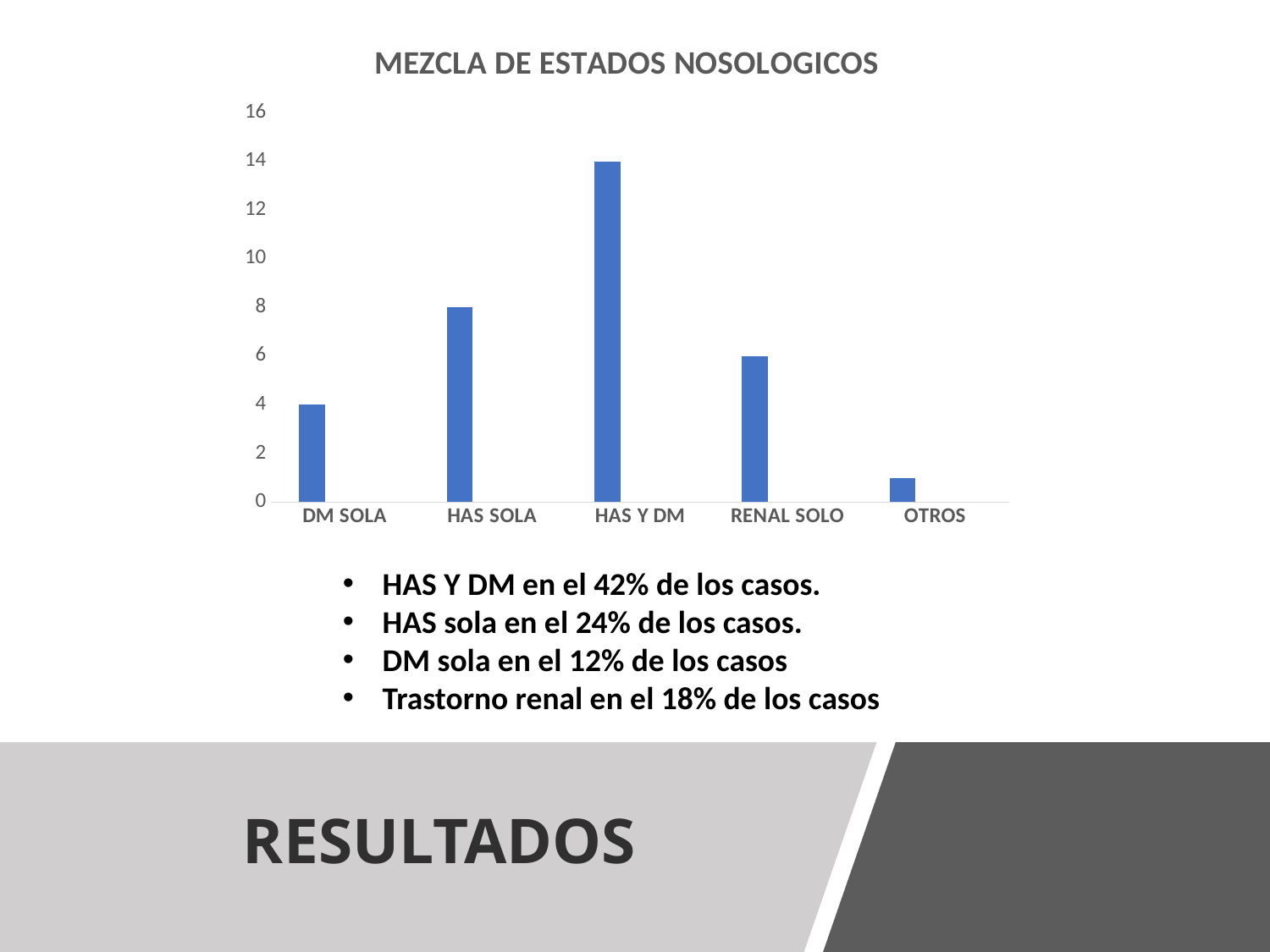
Which category has the lowest bar in the chart? OTROS What is the difference between the values for HAS Y DM and HAS SOLA? 6 What is the value for HAS SOLA? 8 What is the value for DM SOLA? 4 Which is larger, the value for HAS SOLA or the value for RENAL SOLO? HAS SOLA What is the value for HAS Y DM? 14 Which category has the highest bar in the chart? HAS Y DM How many categories are shown on the x axis of the chart? 5 What kind of chart is shown on the slide? bar chart Is the value for OTROS greater or less than 2? less What is the title of the chart? MEZCLA DE ESTADOS NOSOLOGICOS What is the value for RENAL SOLO? 6